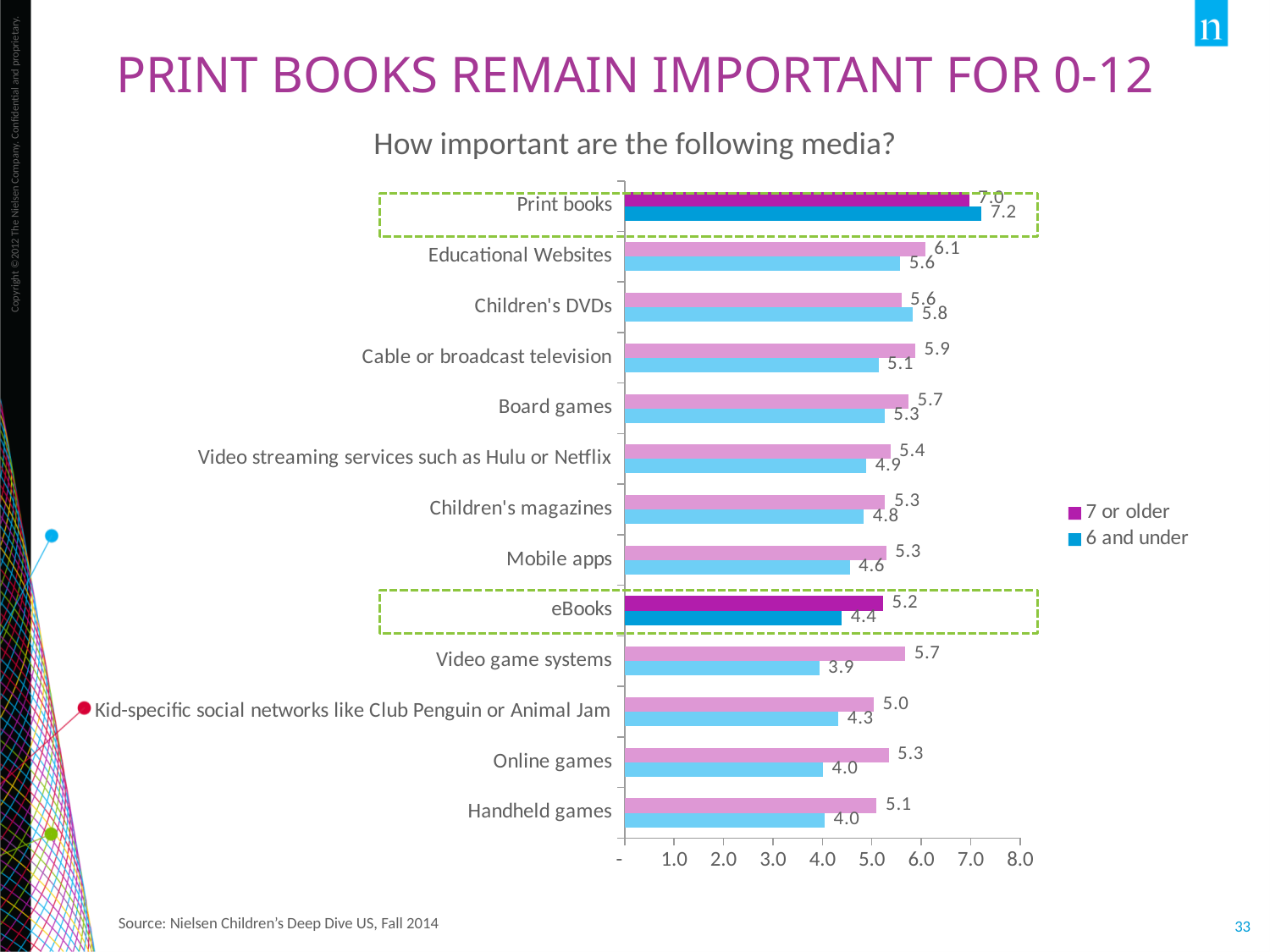
What is the value for Mobile apps in the "6 and under" series? 4.6 Which media category has the lowest value for the "7 or older" series? Kid-specific social networks like Club Penguin or Animal Jam For Children's DVDs, which series has the larger value, "7 or older" or "6 and under"? 6 and under How many media categories are shown in the chart? 13 What is the difference between the "7 or older" and "6 and under" values for eBooks? 0.8 Which media category has the lowest value for the "6 and under" series? Video game systems What type of chart is used on this slide? Bar chart What is the value for Video game systems in the "6 and under" series? 3.9 What is the difference between the "7 or older" and "6 and under" values for Video game systems? 1.8 Is the value for Print books in the "7 or older" series greater or less than 6.0? greater Which media category has the highest value for the "6 and under" series? Print books What is the value for Educational Websites in the "7 or older" series? 6.1